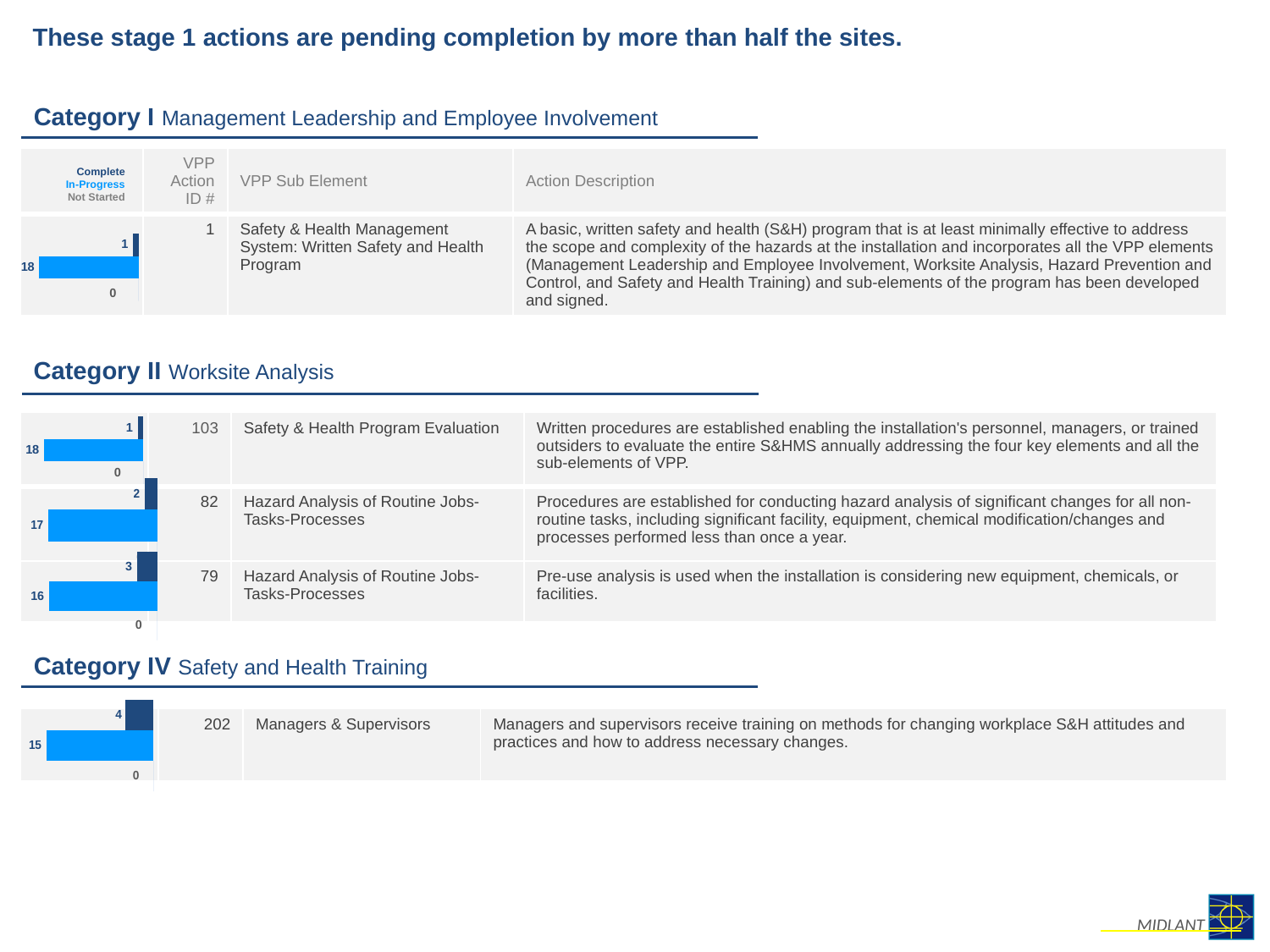
In the bar chart next to VPP Action ID 1, what is the In-Progress value? 18 In the bar chart next to VPP Action ID 82, what is the Complete value? 2 In the bar chart next to VPP Action ID 79, what is the difference between the In-Progress and Complete values? 13 In the bar chart next to VPP Action ID 79, what is the In-Progress value? 16 In the bar chart next to VPP Action ID 202, what is the total of the Complete, In-Progress and Not Started values? 19 Which has a larger Complete value: the chart next to VPP Action ID 82 or the chart next to VPP Action ID 202? VPP Action ID 202 In the bar chart next to VPP Action ID 103, what is the Not Started value? 0 In the bar chart next to VPP Action ID 1, what is the Complete value? 1 In the bar chart next to VPP Action ID 202, which status has the highest value? In-Progress What three statuses does the legend in the Category I table header list? Complete, In-Progress, Not Started What kind of chart is shown next to VPP Action ID 103? bar chart In the bar chart next to VPP Action ID 202, what is the Complete value? 4